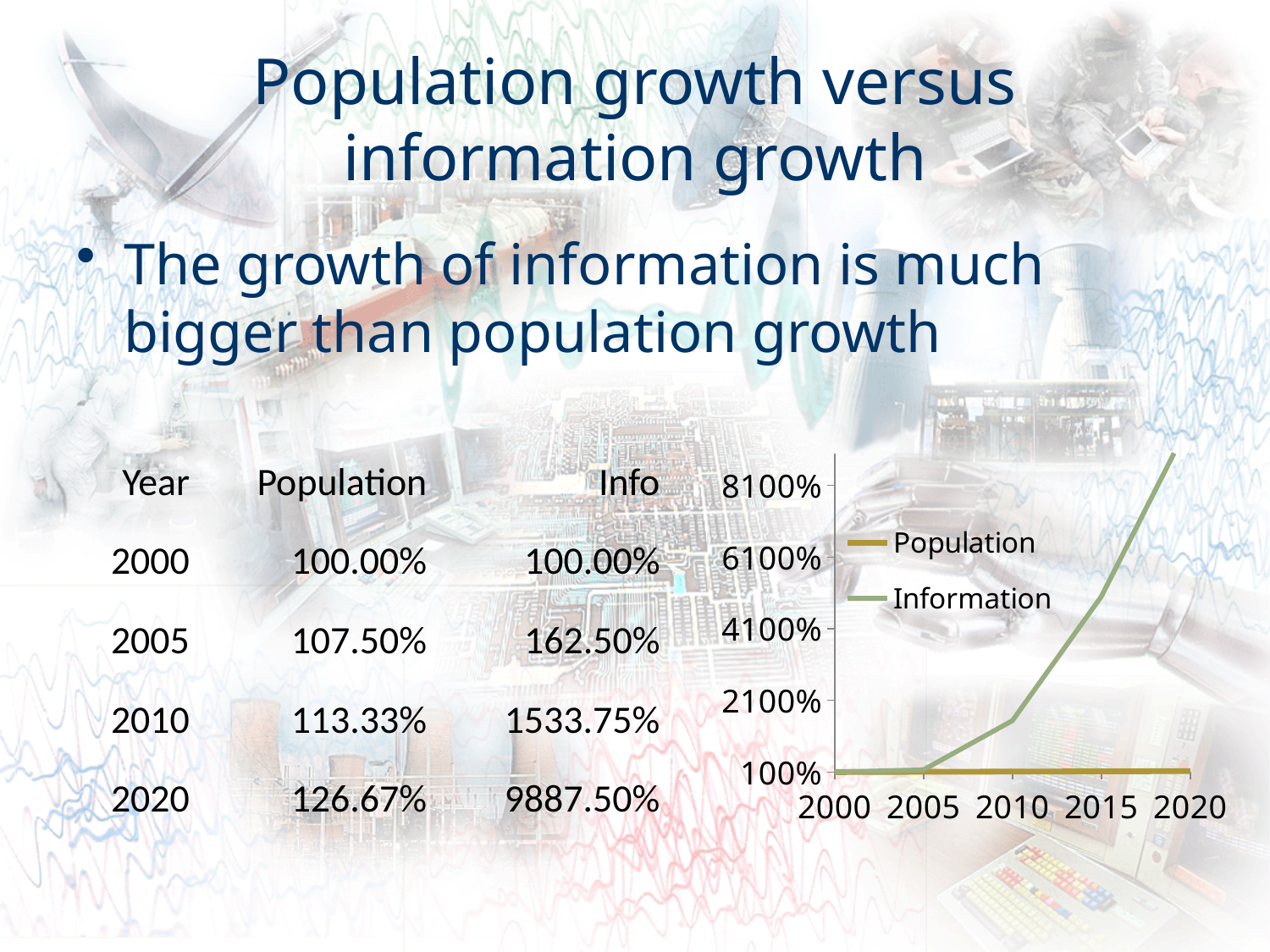
According to the table on the slide, what is the Population value for 2020? 126.67% What kind of chart is shown on the slide? line chart What are the two series named in the chart legend? Population and Information Is the Population value for 2020 greater or less than 2100%? less How many series does the chart legend list? 2 In 2010, which series has the higher value, Population or Information? Information Using the values in the table, what is the difference between the Info and Population values for 2020? 9760.83% According to the table on the slide, what is the Info value for 2010? 1533.75% Does the Information line rise or fall from 2000 to 2020? rises How many year labels appear on the chart's x axis? 5 Is the Information value for 2020 greater or less than 8100%? greater In which year does the Information series reach its highest value? 2020